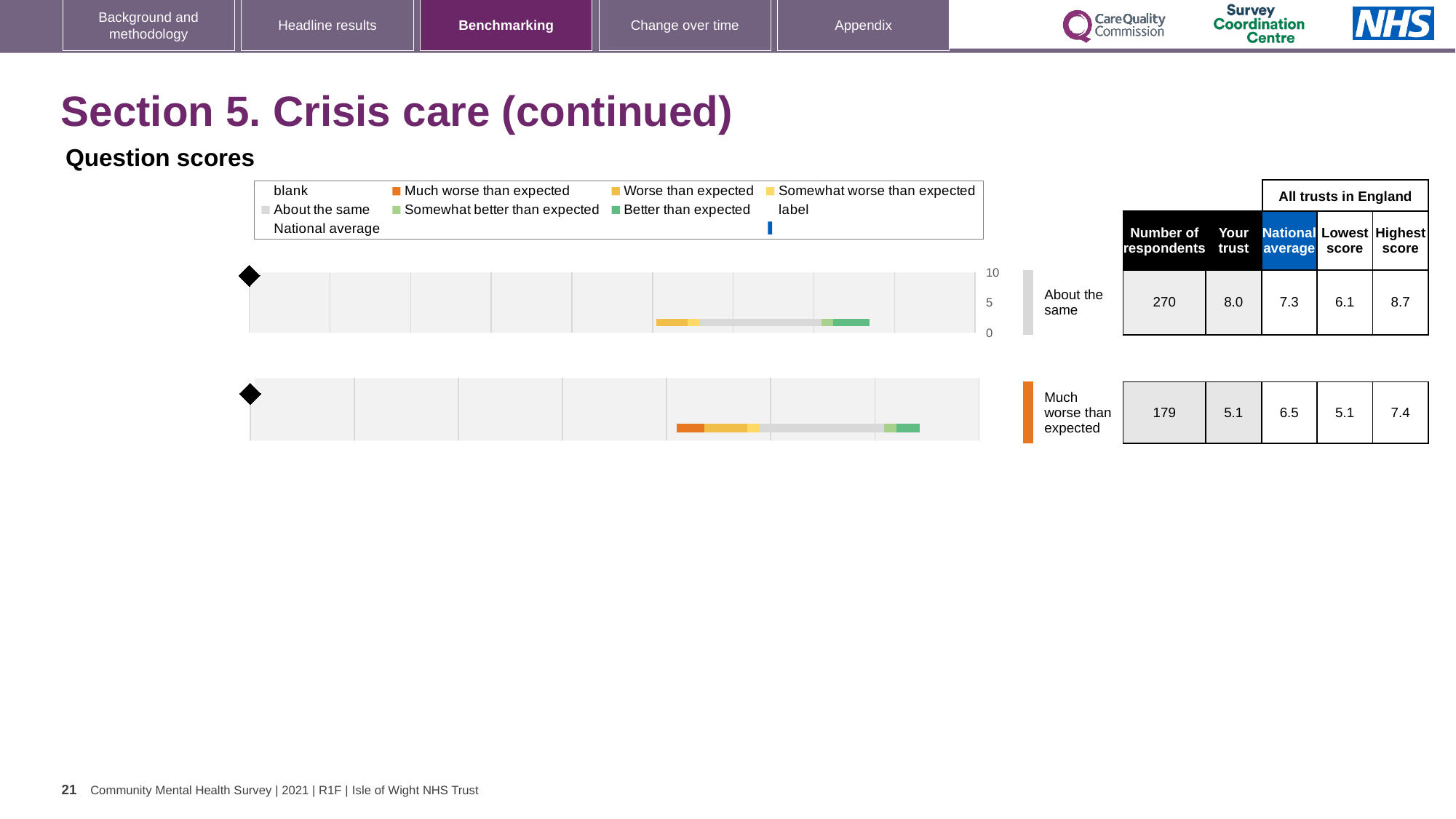
For the row rated 'Much worse than expected', what is the difference between the national average and the 'Your trust' score? 1.4 What is the highest score among all trusts in England for the row rated 'Much worse than expected'? 7.4 In the table, how many respondents are recorded for the row rated 'Much worse than expected'? 179 What kind of chart is used to show the question scores on this slide? Bar chart In the table next to the charts, what is the 'Your trust' score for the row rated 'About the same'? 8.0 For the row rated 'Much worse than expected', which is larger: the 'Your trust' score or the national average? National average For the row rated 'About the same', how much higher is the 'Your trust' score than the national average? 0.7 What is the national average score for the row rated 'About the same'? 7.3 How many question score charts are shown on the slide? 2 Which row has more respondents, 'About the same' or 'Much worse than expected'? About the same What is the lowest score among all trusts in England for the row rated 'About the same'? 6.1 What is the maximum value shown on the vertical axis of the top chart? 10